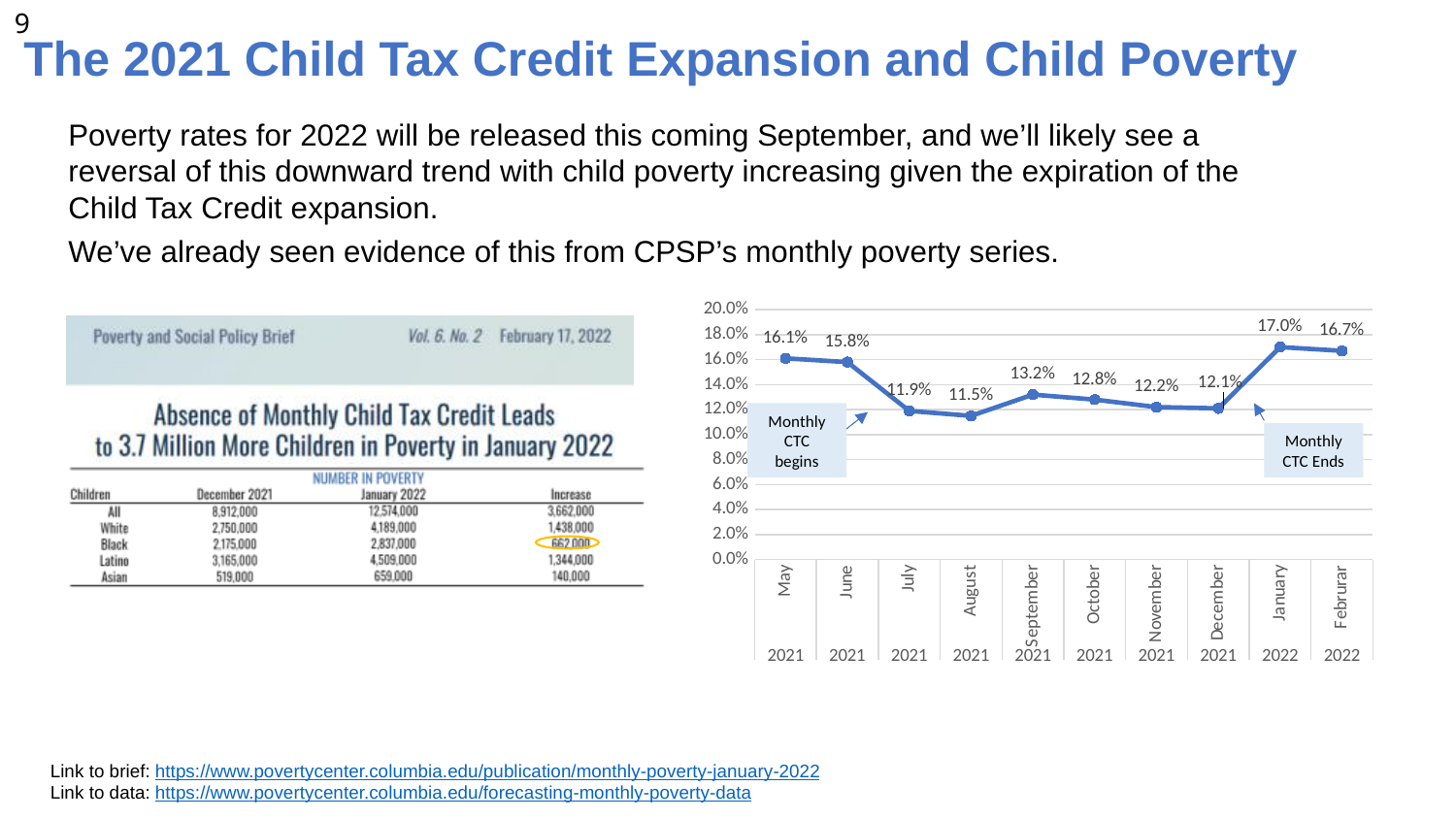
What is the value for August 2021 in the line chart? 11.5% Which is larger in the line chart, the value for June 2021 or the value for July 2021? June 2021 Does the value in the line chart rise or fall from May 2021 to July 2021? fall What is the value for January 2022 in the line chart? 17.0% What does the annotation near the December 2021 point in the line chart say? Monthly CTC Ends How many monthly data points are plotted in the line chart? 10 What is the value for May 2021 in the line chart? 16.1% Which month has the lowest value in the line chart? August 2021 What type of chart is shown on the right side of the slide? line chart What is the value for September 2021 in the line chart? 13.2% What is the difference between the values for January 2022 and December 2021 in the line chart? 4.9% Which month has the highest value in the line chart? January 2022